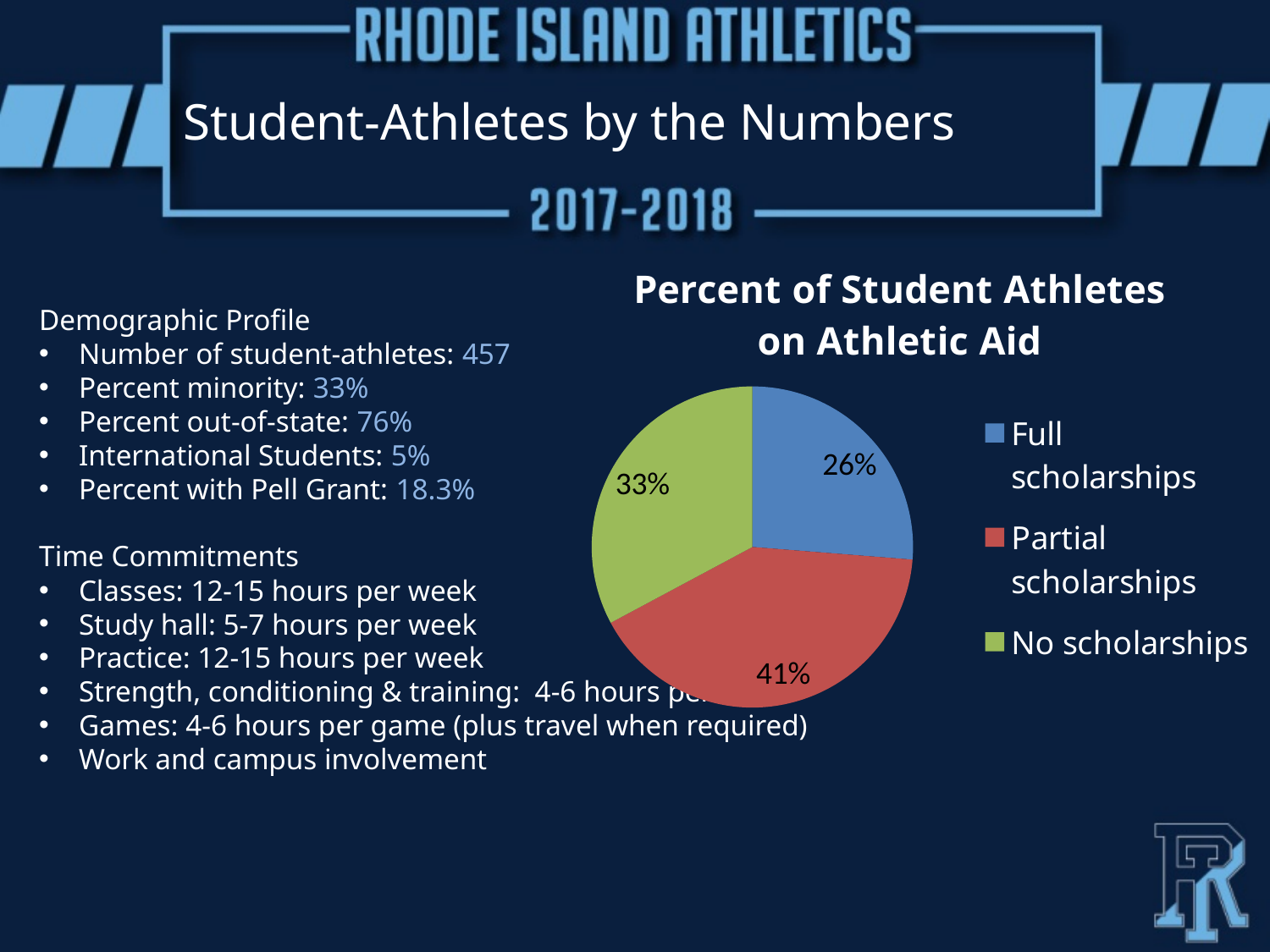
Which is larger, the share for no scholarships or the share for full scholarships? No scholarships What type of chart is shown on the slide? pie chart What colour represents no scholarships in the pie chart? green How many entries does the legend list? 3 What percentage of student athletes have full scholarships? 26% What percentage of student athletes have partial scholarships? 41% What is the title of the chart? Percent of Student Athletes on Athletic Aid What is the difference in percentage points between partial scholarships and full scholarships? 15 Which category has the smallest share of the pie? Full scholarships What percentage of student athletes have no scholarships? 33% How many categories does the pie chart show? 3 Which category has the largest share of the pie? Partial scholarships